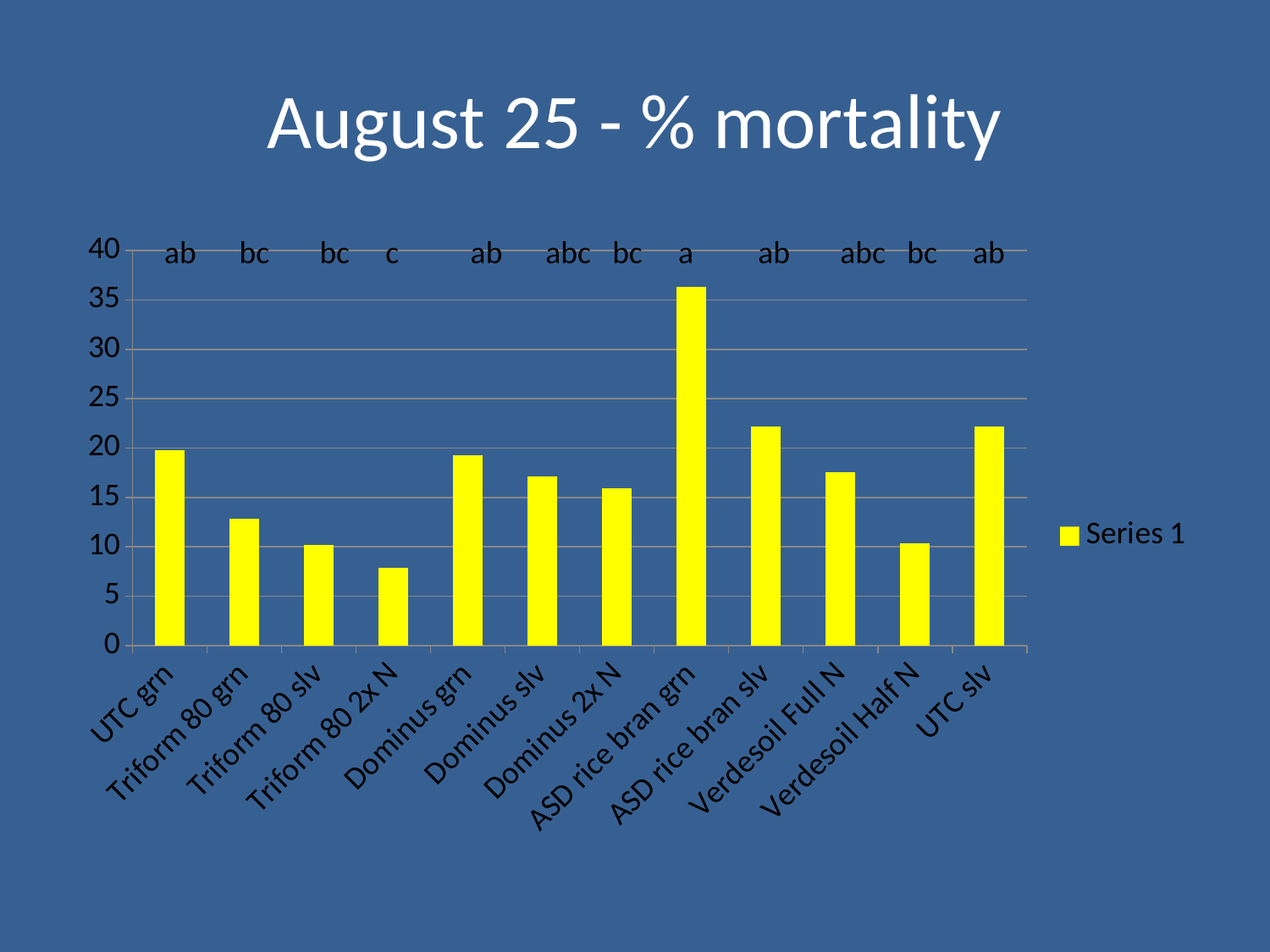
Is the value for ASD rice bran grn greater or less than 35? greater Is the value for Triform 80 2x N greater or less than 10? less How many categories are shown on the x axis of the chart? 12 Which category has the lowest % mortality? Triform 80 2x N Is the value for Triform 80 grn greater or less than 15? less What kind of chart is shown on the slide? bar chart Which category has the highest % mortality? ASD rice bran grn Which is larger, the value for ASD rice bran grn or the value for UTC slv? ASD rice bran grn How many series does the legend list? 1 What is the title of the chart? August 25 - % mortality Which is larger, the value for Triform 80 grn or the value for Dominus grn? Dominus grn